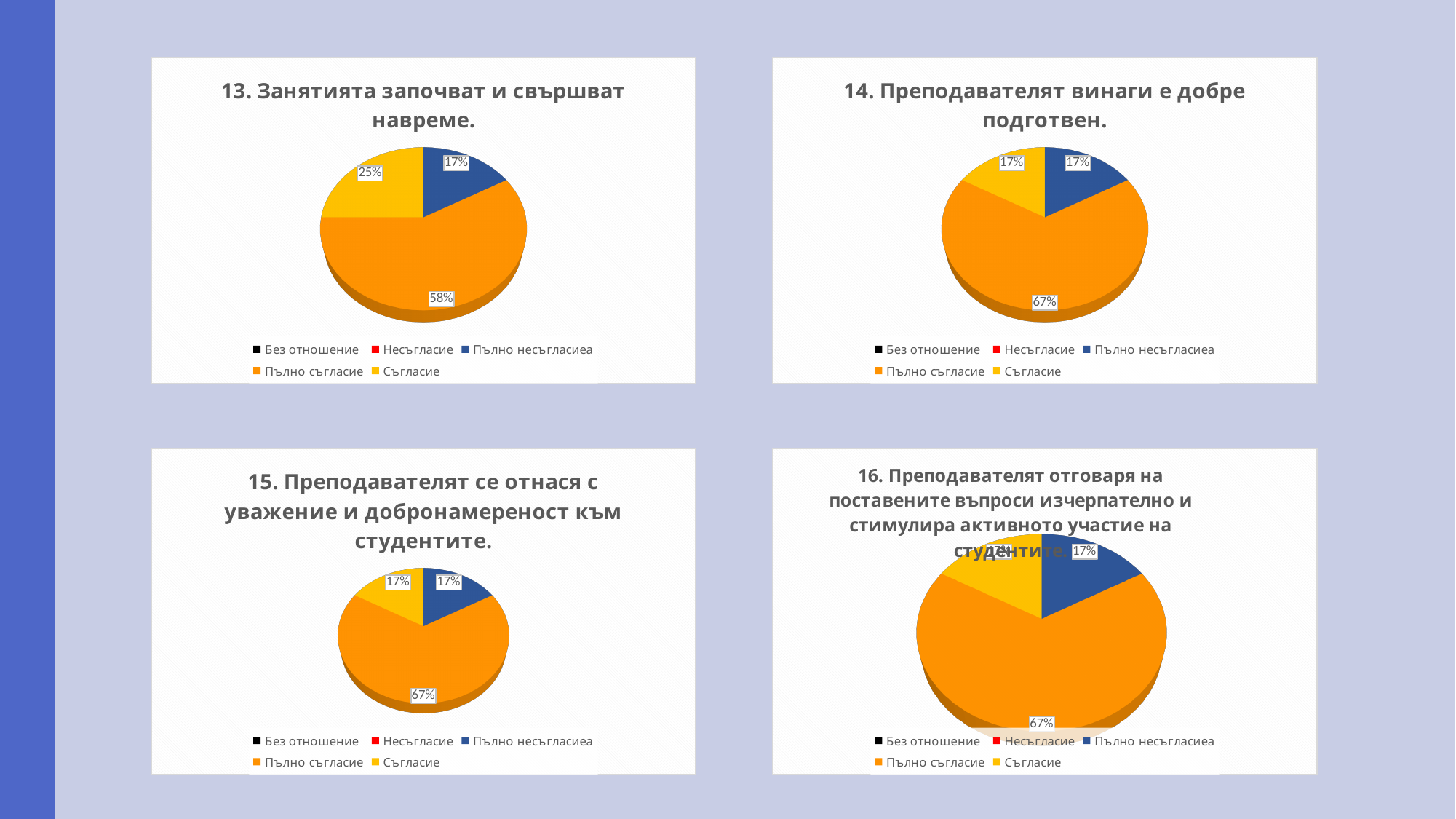
In the chart titled "13. Занятията започват и свършват навреме.", what share does the "Пълно съгласие" slice have? 58% In the chart titled "14. Преподавателят винаги е добре подготвен.", what share does the "Пълно съгласие" slice have? 67% In the chart titled "13. Занятията започват и свършват навреме.", what is the difference between the "Пълно съгласие" and "Съгласие" slices? 33% In the chart titled "13. Занятията започват и свършват навреме.", what share does the "Пълно несъгласиеа" slice have? 17% How many entries does the legend of the chart titled "13. Занятията започват и свършват навреме." list? 5 In the chart titled "15. Преподавателят се отнася с уважение и добронамереност към студентите.", which category has the largest slice? Пълно съгласие In the bottom-right chart (question 16), what share does the "Пълно несъгласиеа" slice have? 17% In the chart titled "14. Преподавателят винаги е добре подготвен.", what share does the "Съгласие" slice have? 17% In the chart titled "15. Преподавателят се отнася с уважение и добронамереност към студентите.", what share does the "Пълно съгласие" slice have? 67% In the chart titled "13. Занятията започват и свършват навреме.", which category has the largest slice? Пълно съгласие In the bottom-right chart (question 16), is the "Пълно съгласие" slice larger or smaller than the "Пълно несъгласиеа" slice? larger In the chart titled "13. Занятията започват и свършват навреме.", what share does the "Съгласие" slice have? 25%